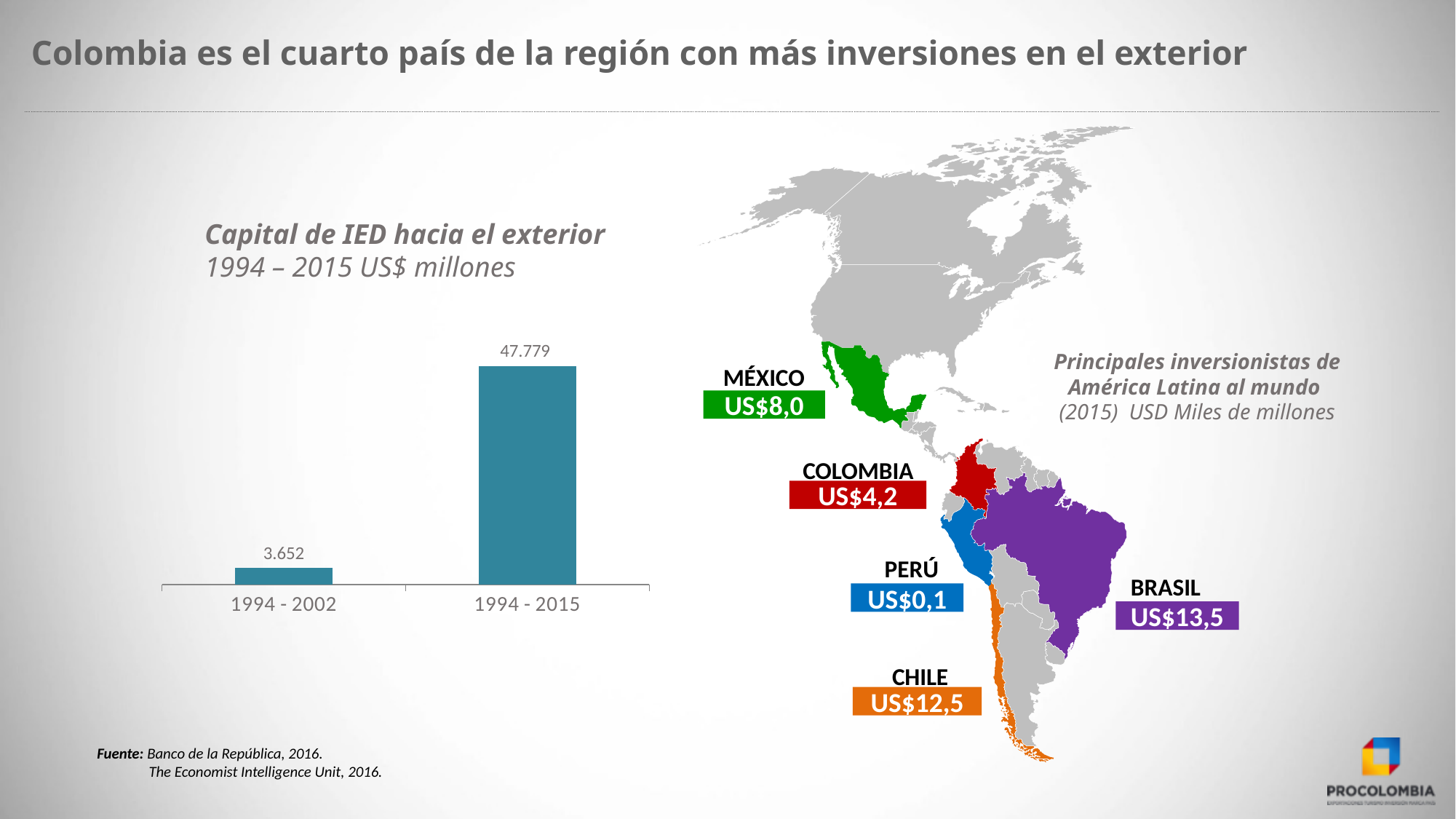
In the bar chart 'Capital de IED hacia el exterior', what unit is stated in the subtitle? US$ millones In the map 'Principales inversionistas de América Latina al mundo', how many countries have values labelled? 5 In the bar chart 'Capital de IED hacia el exterior', what is the value for 1994 - 2015? 47.779 In the map 'Principales inversionistas de América Latina al mundo', what is the value for Colombia? US$4,2 In the map 'Principales inversionistas de América Latina al mundo', which country has the lowest value? Perú What type of chart is 'Capital de IED hacia el exterior'? Bar chart In the bar chart 'Capital de IED hacia el exterior', which period has the higher value? 1994 - 2015 In the bar chart 'Capital de IED hacia el exterior', which period has the lower value? 1994 - 2002 In the bar chart 'Capital de IED hacia el exterior', how many bars are shown? 2 In the bar chart 'Capital de IED hacia el exterior', what is the difference between the 1994 - 2015 value and the 1994 - 2002 value? 44.127 In the bar chart 'Capital de IED hacia el exterior', what is the value for 1994 - 2002? 3.652 In the map 'Principales inversionistas de América Latina al mundo', which country has the highest value? Brasil